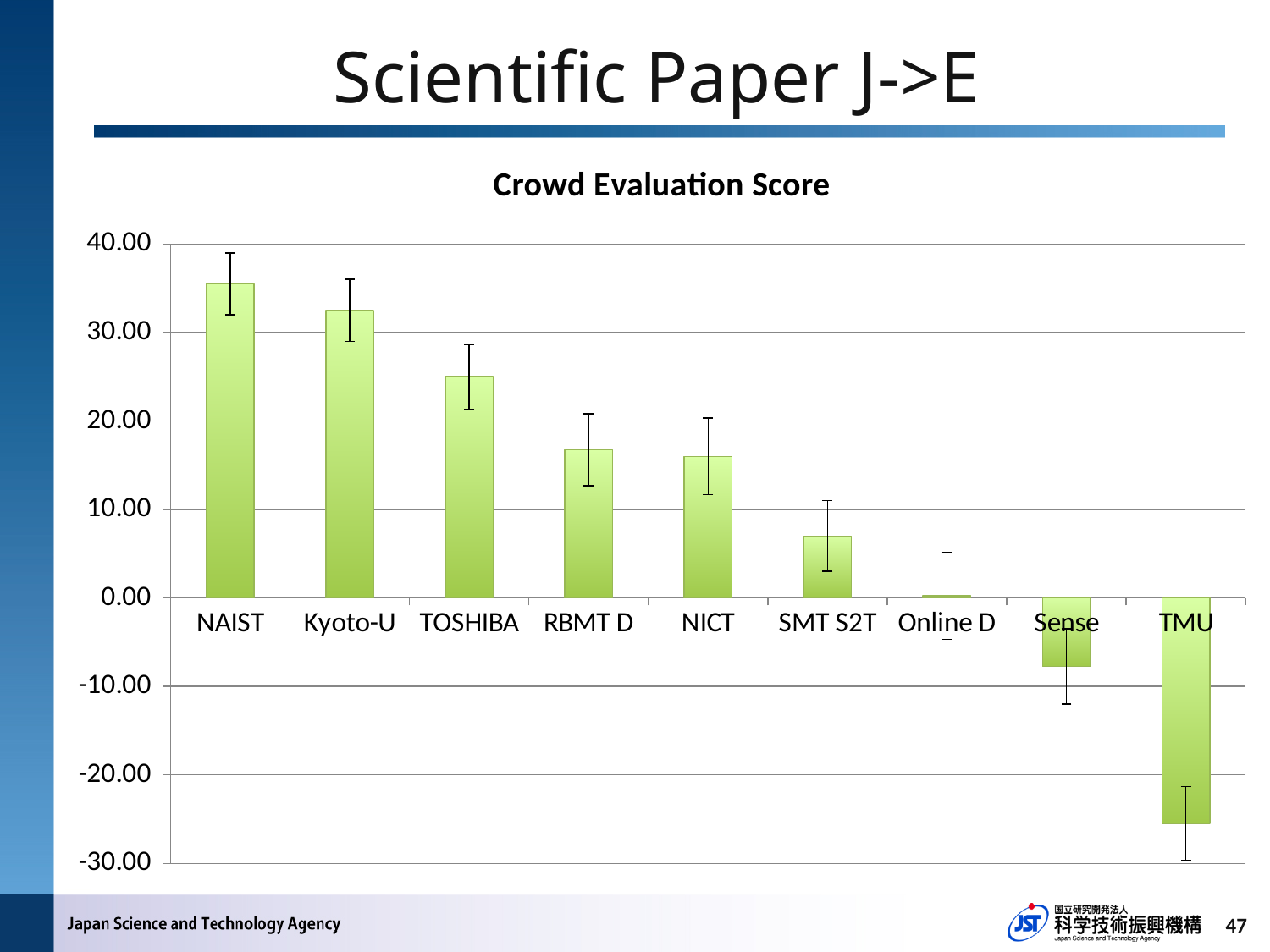
What kind of chart is shown on the slide? bar chart Do the values rise or fall moving from left to right along the x axis? fall Is the value for TMU greater or less than -20.00? less How many categories are plotted on the x axis? 9 Which has a larger Crowd Evaluation Score, Sense or SMT S2T? SMT S2T Is the value for TOSHIBA greater or less than 30.00? less Is the value for SMT S2T greater or less than 10.00? less Which category has the highest Crowd Evaluation Score? NAIST What is the title of the chart? Crowd Evaluation Score Which has a larger Crowd Evaluation Score, Kyoto-U or TOSHIBA? Kyoto-U Which category has the lowest Crowd Evaluation Score? TMU